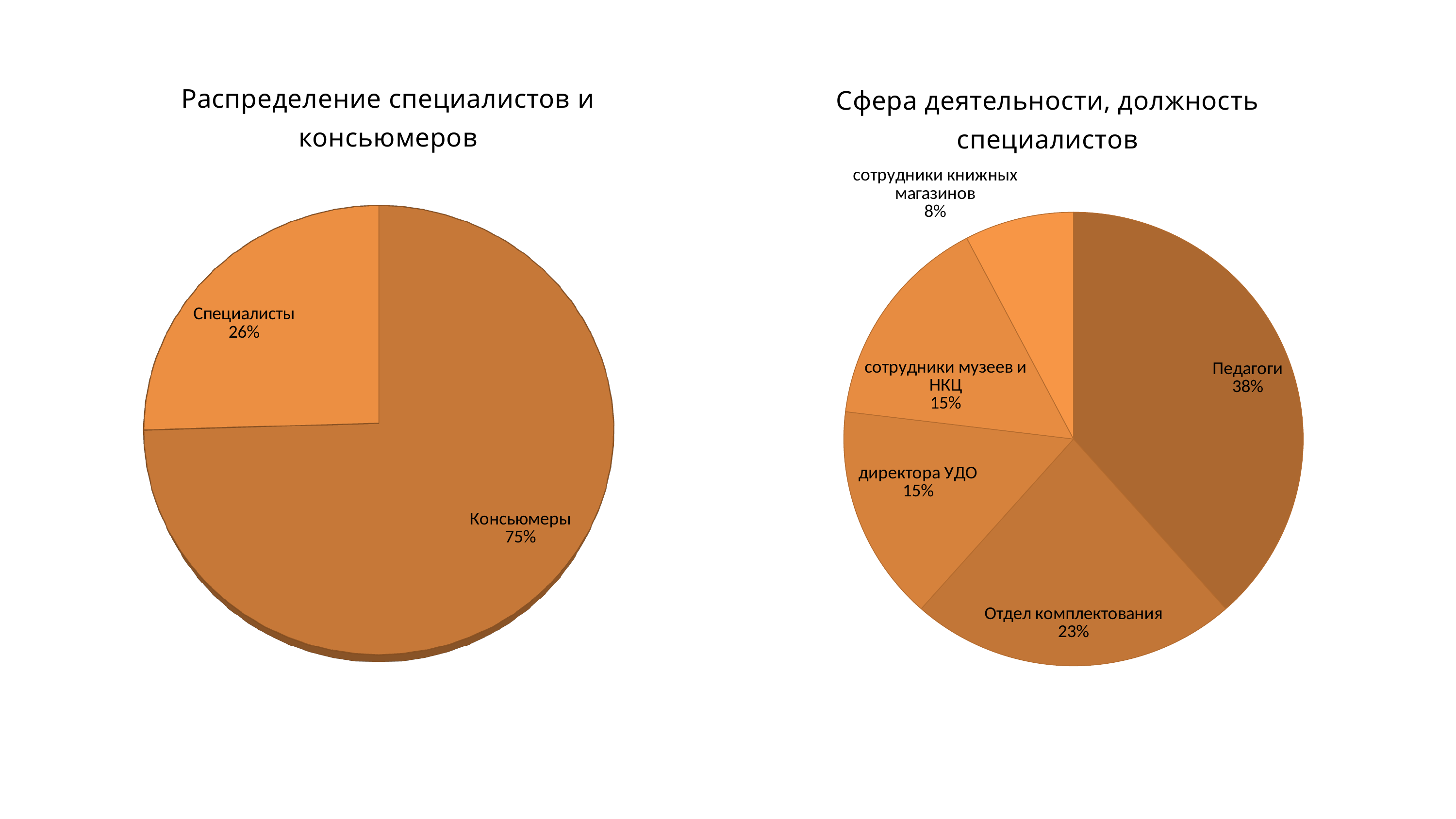
In the chart titled "Сфера деятельности, должность специалистов", what is the difference in percentage points between Педагоги and Отдел комплектования? 15 In the chart titled "Сфера деятельности, должность специалистов", which category has the largest share? Педагоги In the chart titled "Сфера деятельности, должность специалистов", which category has the smallest share? сотрудники книжных магазинов In the chart titled "Сфера деятельности, должность специалистов", how many categories are shown? 5 In the chart titled "Распределение специалистов и консьюмеров", what share is labelled for Консьюмеры? 75% In the chart titled "Сфера деятельности, должность специалистов", what share is labelled for Педагоги? 38% In the chart titled "Сфера деятельности, должность специалистов", what share is labelled for Отдел комплектования? 23% In the chart titled "Распределение специалистов и консьюмеров", how many slices does the pie have? 2 In the chart titled "Распределение специалистов и консьюмеров", which slice is larger, Специалисты or Консьюмеры? Консьюмеры In the chart titled "Сфера деятельности, должность специалистов", what share is labelled for сотрудники книжных магазинов? 8% What kind of chart is the left chart on the slide? Pie chart In the chart titled "Распределение специалистов и консьюмеров", what share is labelled for Специалисты? 26%